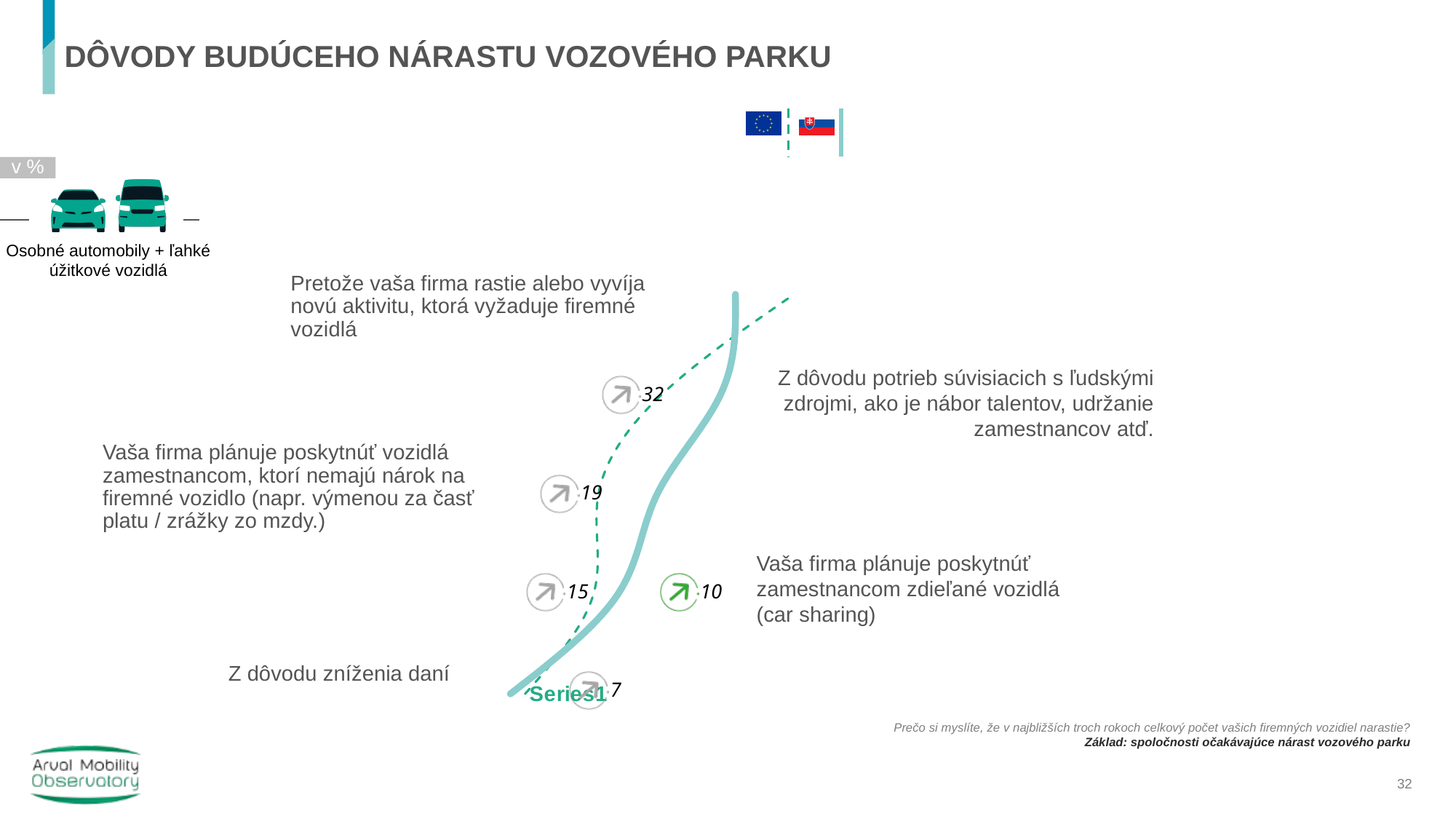
What kind of chart is shown on the slide? line chart What is the difference between the values 19 and 15 shown on the chart? 4 What is the difference between the highest value (32) and the lowest value (7) on the chart? 25 In what unit are the chart values expressed, according to the label at the top left? v % How many data points are labelled on the chart? 5 What value is shown for the reason 'Vaša firma plánuje poskytnúť zamestnancom zdieľané vozidlá (car sharing)'? 10 What value is shown for the reason 'Pretože vaša firma rastie alebo vyvíja novú aktivitu, ktorá vyžaduje firemné vozidlá'? 32 What is the lowest value shown on the chart? 7 What is the highest value shown on the chart? 32 What is the name of the series shown in the chart legend? Series1 Which is larger, the value 19 or the value 10 on the chart? 19 How many series does the chart legend list? 1